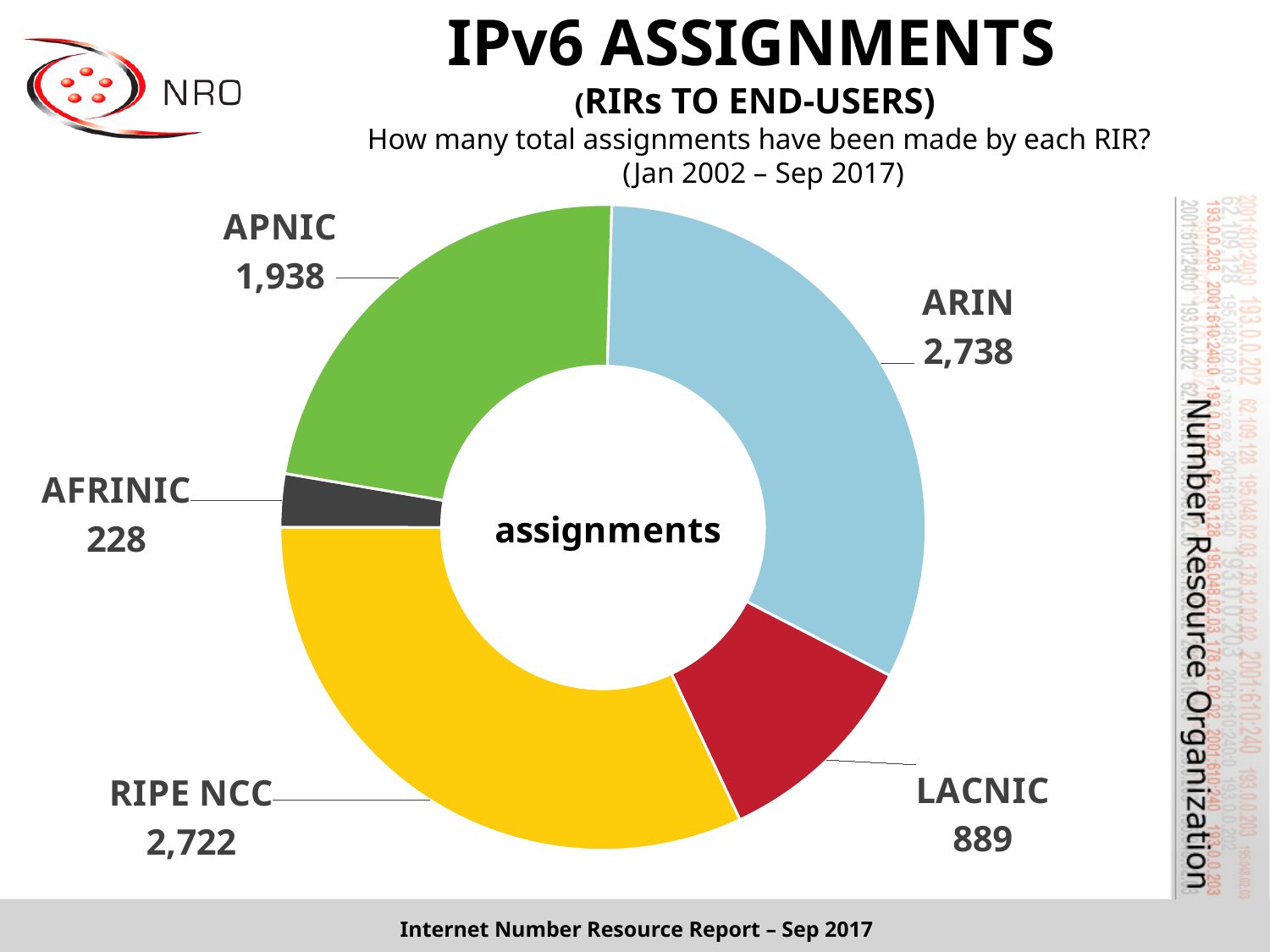
What is the value shown for LACNIC? 889 How many IPv6 assignments has ARIN made according to the chart? 2,738 How many RIRs are shown in the chart? 5 What is the total number of assignments across all five RIRs? 8,515 What is the difference between the assignments of APNIC and LACNIC? 1,049 What is the difference between the assignments of ARIN and RIPE NCC? 16 What is the value shown for AFRINIC? 228 What kind of chart is shown on the slide? Doughnut chart Which RIR has the highest number of assignments? ARIN Which RIR has the lowest number of assignments? AFRINIC Which has more assignments, APNIC or LACNIC? APNIC What word is printed in the centre of the chart? assignments